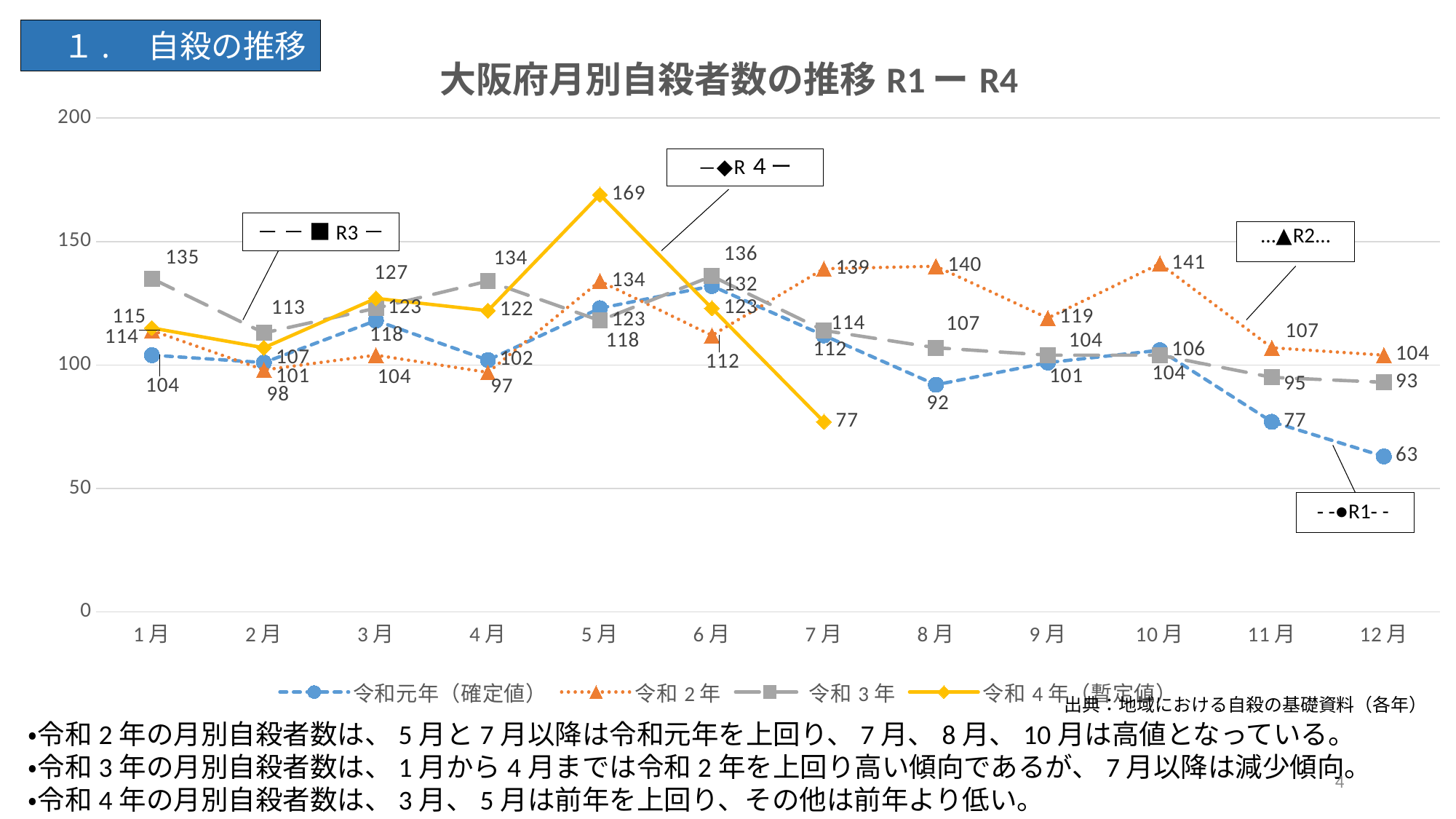
In 8月, which series has the larger value, 令和元年（確定値） or 令和2年? 令和2年 What is the value for 令和3年 in 1月? 135 In which month does the 令和元年（確定値） series reach its lowest value? 12月 What kind of chart is shown on the slide? line chart How many series does the legend list? 4 What is the difference between the 令和4年（暫定値） values for 5月 and 7月? 92 Does the 令和元年（確定値） series rise or fall from 10月 to 12月? fall How many months are plotted along the x axis? 12 What is the value for 令和4年（暫定値） in 5月? 169 What is the title of the chart? 大阪府月別自殺者数の推移 R1 ー R4 In which month does the 令和4年（暫定値） series reach its highest value? 5月 What is the value for 令和2年 in 12月? 104